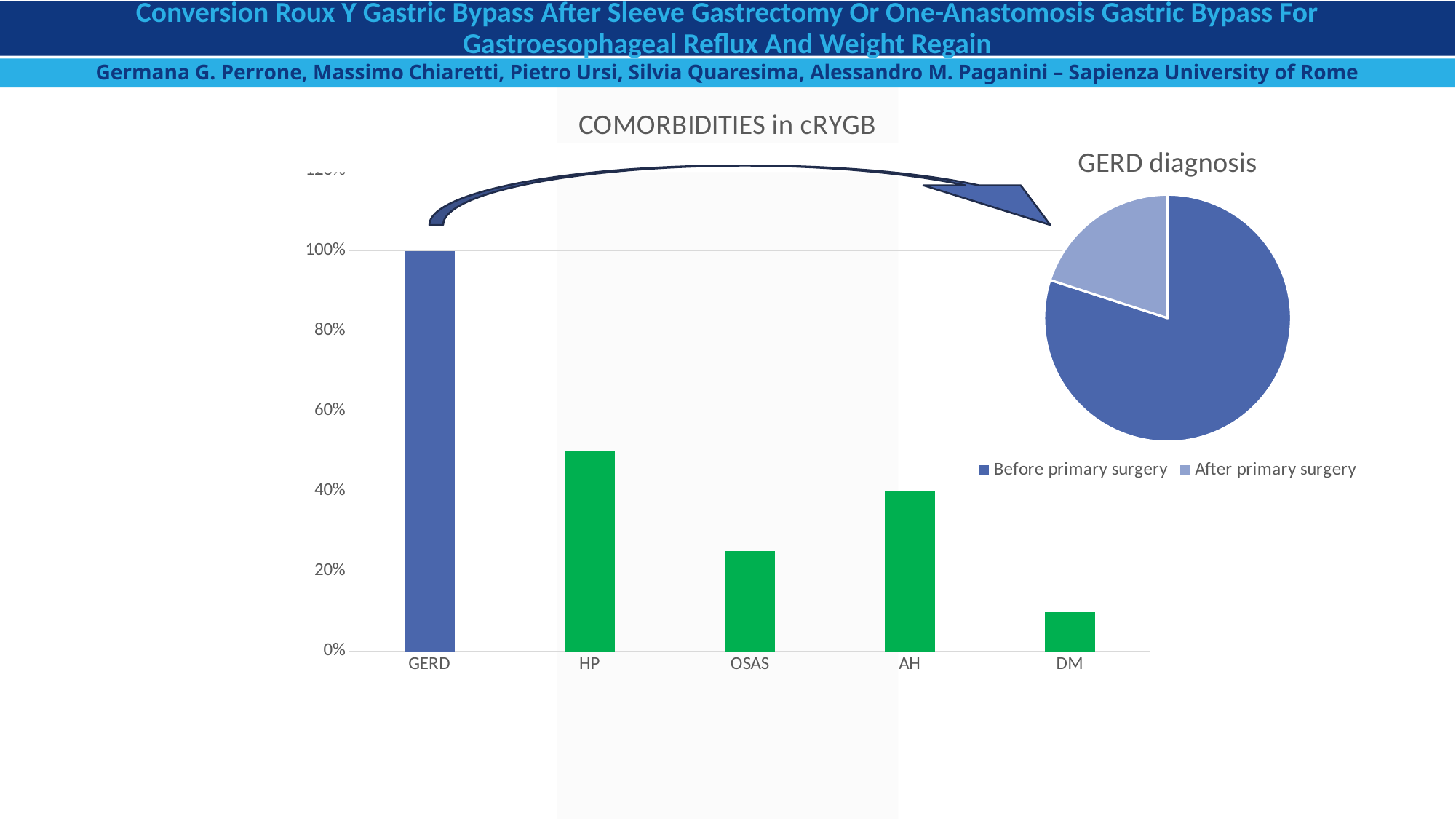
In the COMORBIDITIES in cRYGB chart, is the value for DM greater or less than 20%? less In the COMORBIDITIES in cRYGB chart, what kind of chart is used? bar chart In the COMORBIDITIES in cRYGB chart, how many comorbidity categories are shown on the x axis? 5 In the COMORBIDITIES in cRYGB chart, which category has the lowest value? DM In the COMORBIDITIES in cRYGB chart, what is the value for GERD? 100% In the COMORBIDITIES in cRYGB chart, what is the value for AH? 40% In the GERD diagnosis pie chart, how many entries does the legend list? 2 In the COMORBIDITIES in cRYGB chart, is the value for HP greater or less than 40%? greater In the COMORBIDITIES in cRYGB chart, what is the difference between the values for GERD and AH? 60% In the COMORBIDITIES in cRYGB chart, which category has the highest value? GERD In the COMORBIDITIES in cRYGB chart, which is larger, the value for HP or the value for AH? HP In the COMORBIDITIES in cRYGB chart, is the value for OSAS greater or less than 20%? greater